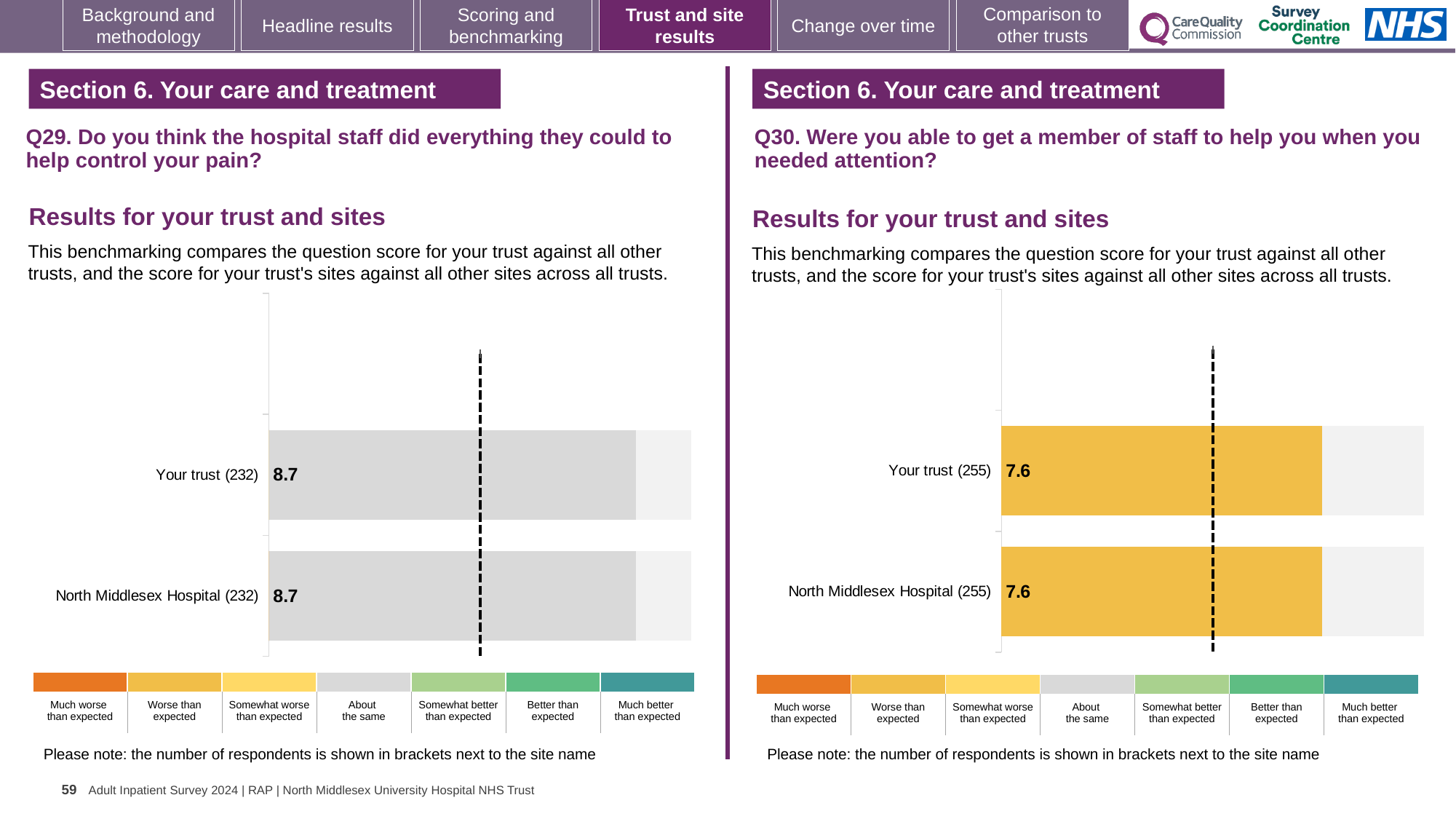
How many bars are plotted on the Q30 chart (right)? 2 On the Q30 chart (right), what is the score for North Middlesex Hospital? 7.6 On the Q30 chart (right), which benchmark category does the yellow colour of the bars correspond to in the legend? Worse than expected What kind of chart is used on the Q30 chart (right)? Bar chart On the Q29 chart (left), what is the difference between the score for Your trust and the score for North Middlesex Hospital? 0.0 On the Q30 chart (right), what is the difference between the score for Your trust and the score for North Middlesex Hospital? 0.0 On the Q29 chart (left), how many respondents are shown in brackets next to Your trust? 232 How many bars are plotted on the Q29 chart (left)? 2 On the Q30 chart (right), what is the score for Your trust? 7.6 On the Q29 chart (left), what is the score for Your trust? 8.7 On the Q29 chart (left), what is the score for North Middlesex Hospital? 8.7